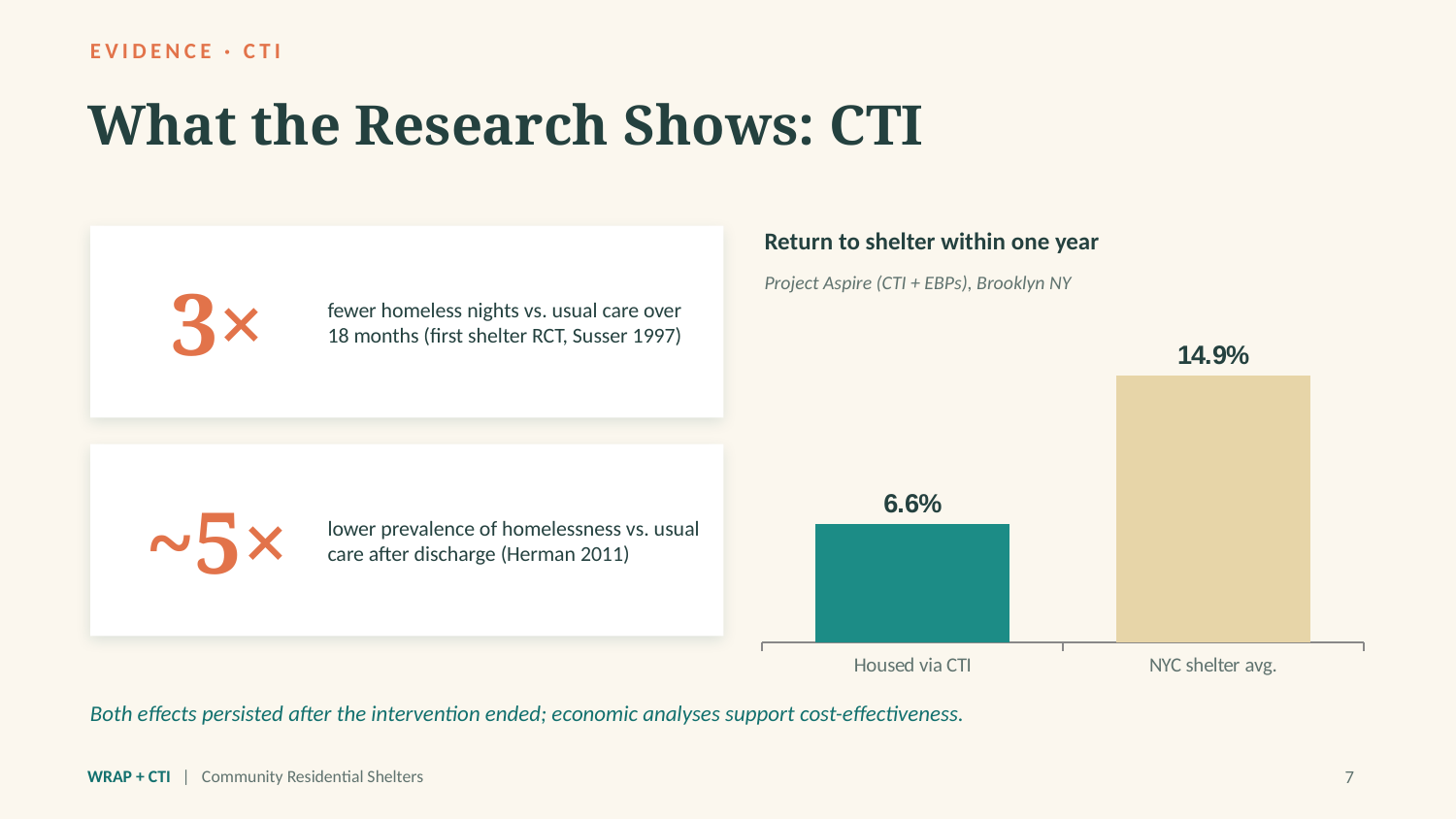
Which is larger, the value for Housed via CTI or the value for NYC shelter avg.? NYC shelter avg. Which category has the highest return-to-shelter rate? NYC shelter avg. What kind of chart is shown on the slide? Bar chart What is the title of the chart? Return to shelter within one year What is the return-to-shelter rate for NYC shelter avg.? 14.9% What is the difference between the NYC shelter avg. and Housed via CTI return-to-shelter rates? 8.3% How many categories are shown in the chart? 2 Which category has the lowest return-to-shelter rate? Housed via CTI What is the return-to-shelter rate for Housed via CTI? 6.6% What is the subtitle shown under the chart title? Project Aspire (CTI + EBPs), Brooklyn NY